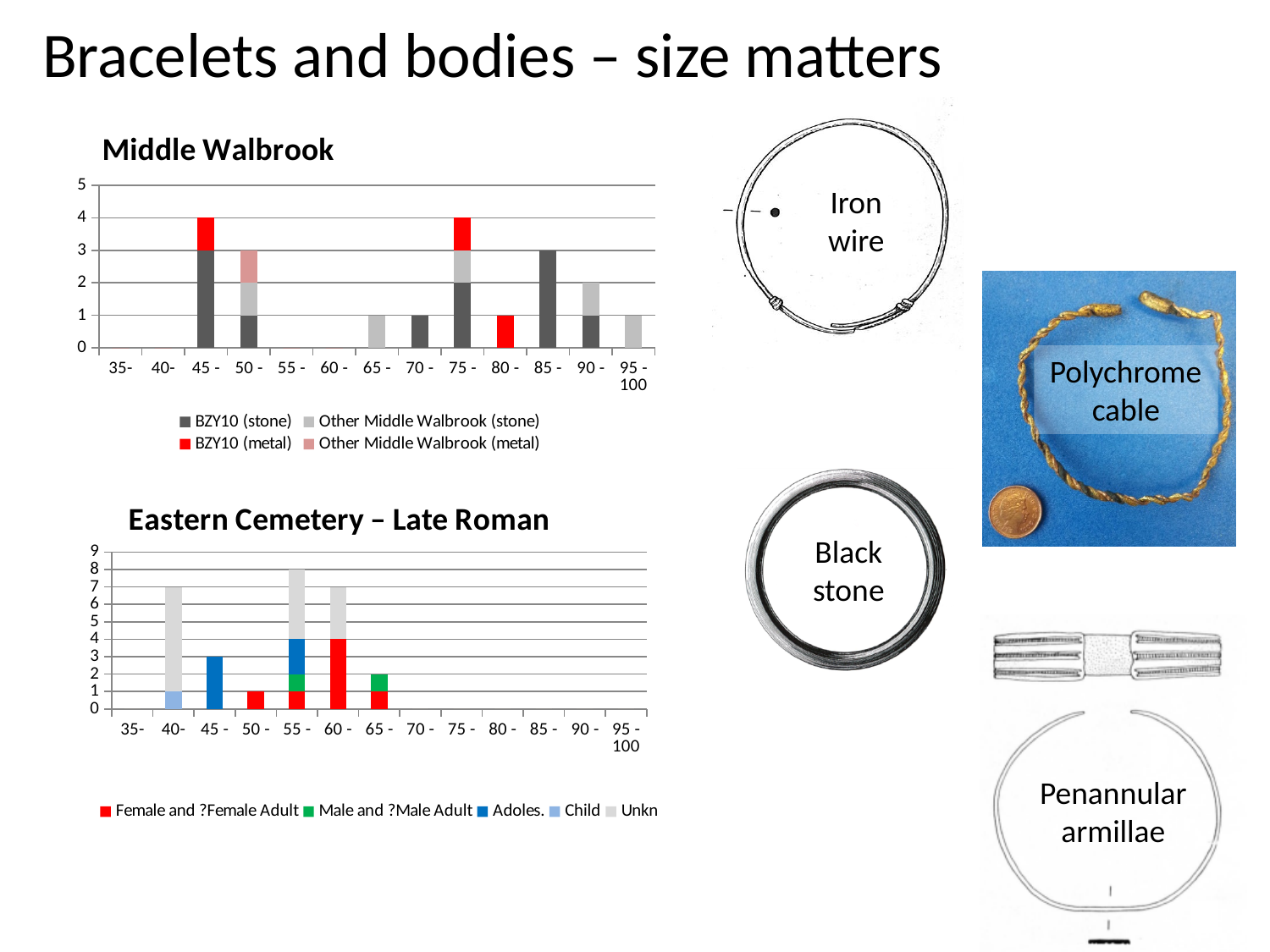
In the Middle Walbrook chart, what is the total height of the stacked bar for the 50 - category? 3 In the Eastern Cemetery – Late Roman chart, how many series does the legend list? 5 In the Middle Walbrook chart, what is the value of the BZY10 (stone) series for the 85 - category? 3 In the Eastern Cemetery – Late Roman chart, which category has the highest total? 55 - In the Eastern Cemetery – Late Roman chart, what is the value of the Adoles. series for the 45 - category? 3 In the Middle Walbrook chart, how many series does the legend list? 4 In the Middle Walbrook chart, what is the total height of the stacked bar for the 45 - category? 4 In the Eastern Cemetery – Late Roman chart, what is the total height of the stacked bar for the 60 - category? 7 In the Eastern Cemetery – Late Roman chart, which is larger: the total for 40 - or the total for 65 -? 40 - How many categories are shown on the x axis of the Eastern Cemetery – Late Roman chart? 13 What kind of chart is the Eastern Cemetery – Late Roman chart? Stacked bar chart In the Middle Walbrook chart, is the total for the 75 - category greater or less than 3? greater